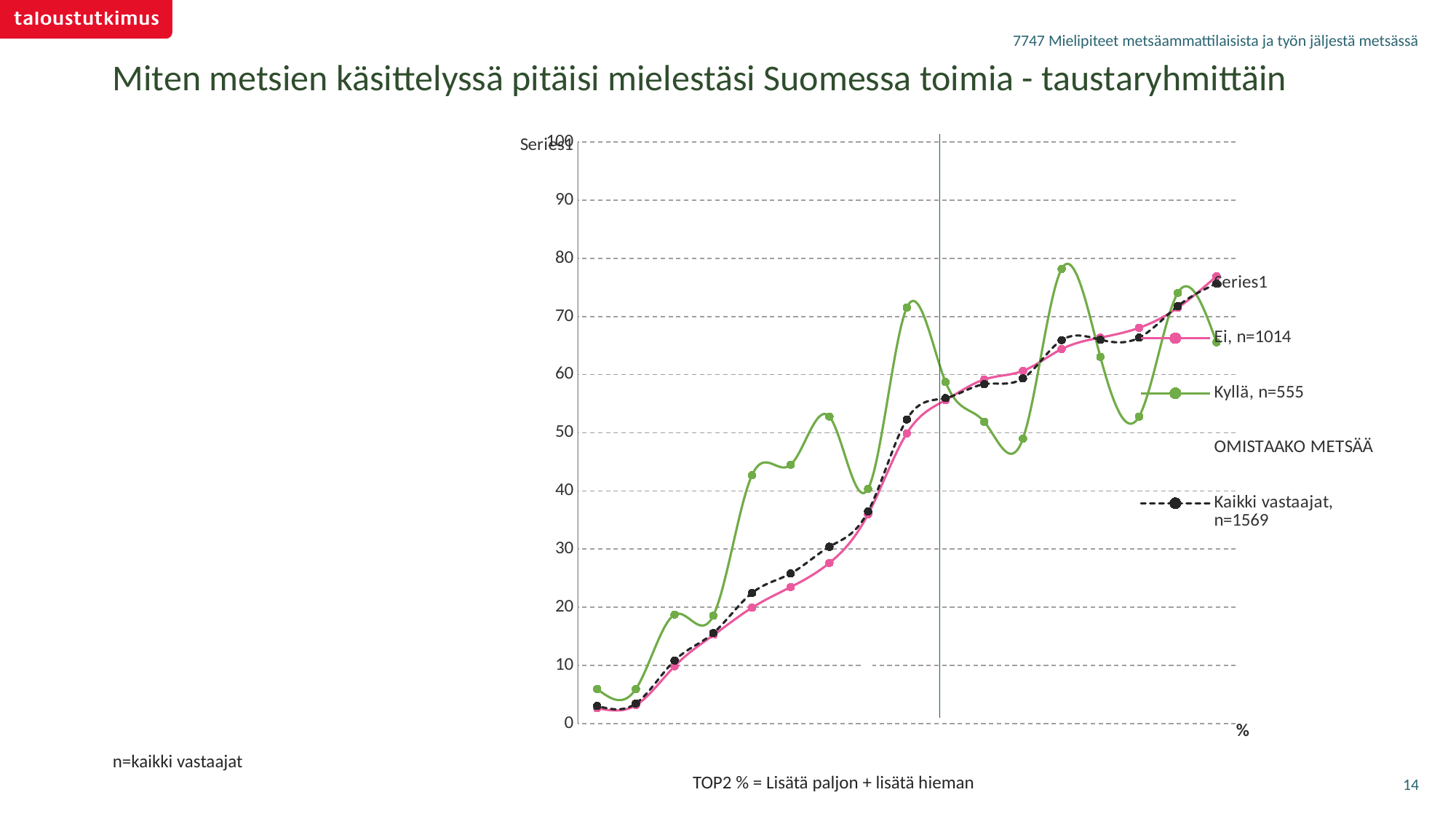
How many respondents (n) are in the 'Kaikki vastaajat' series? 1569 What kind of chart is shown on the slide? line chart What is the maximum value shown on the vertical axis? 100 What is the title of the chart on the slide? Miten metsien käsittelyssä pitäisi mielestäsi Suomessa toimia - taustaryhmittäin Is the lowest point of the 'Ei, n=1014' line greater or less than 10? less At the leftmost point of the chart, which series has the highest value? Kyllä, n=555 Is the highest point of the 'Kyllä, n=555' line greater or less than 70? greater Which legend entry is drawn as a green line? Kyllä, n=555 How many respondents (n) are in the 'Ei' series? 1014 Do the values of the 'Kaikki vastaajat, n=1569' line generally rise or fall from left to right along the x axis? rise What unit is indicated at the bottom right of the chart's axis? %